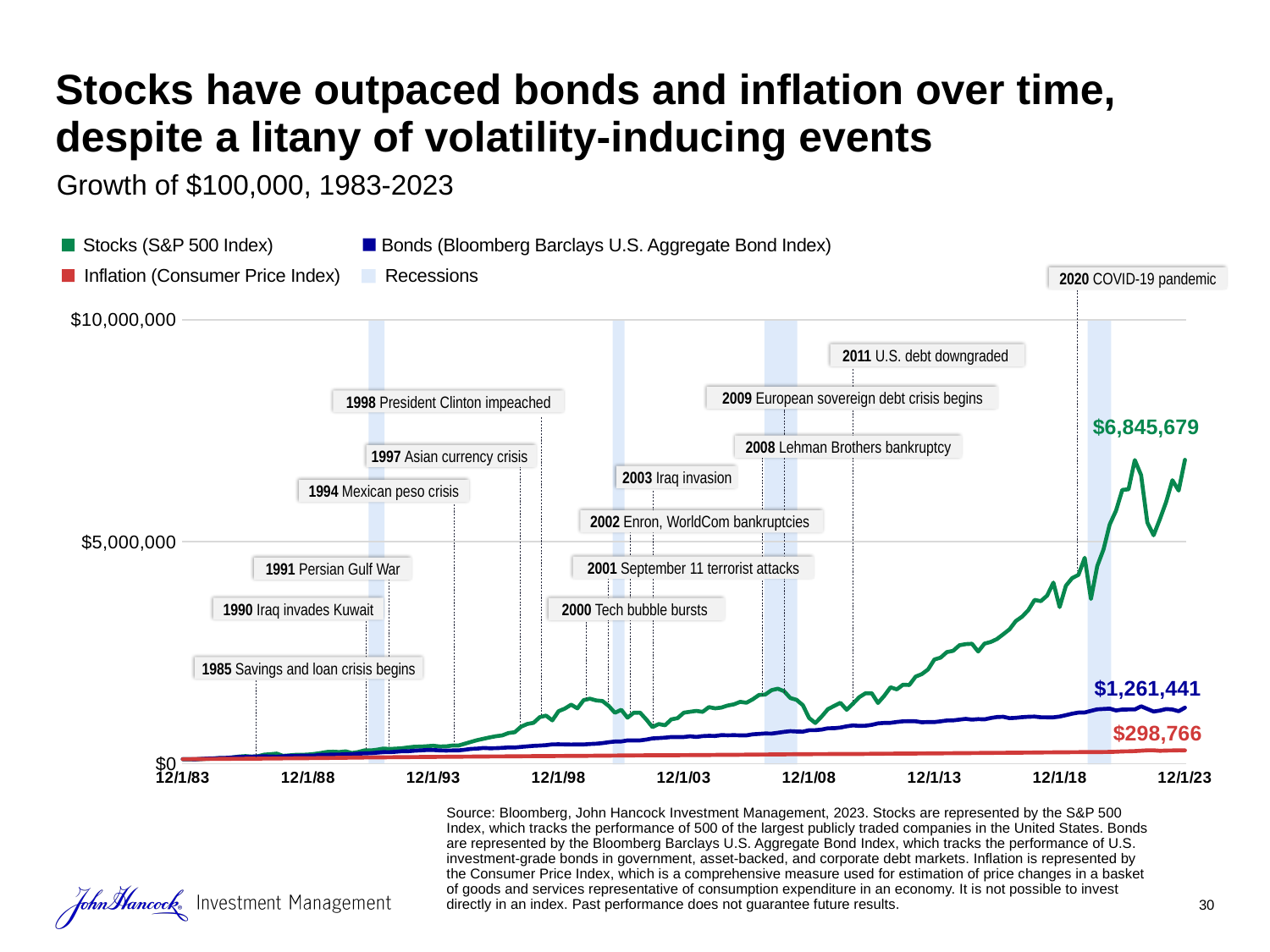
What is the ending value shown for Bonds (Bloomberg Barclays U.S. Aggregate Bond Index)? $1,261,441 How many entries does the legend list? 4 What is the ending value shown for Stocks (S&P 500 Index) on the chart? $6,845,679 What is the difference between the ending values of Bonds and Inflation? $962,675 What is the difference between the ending values of Stocks and Bonds? $5,584,238 What is the ending value shown for Inflation (Consumer Price Index)? $298,766 Is the ending value for Stocks greater or less than $5,000,000? greater Which series has the lowest ending value on the chart? Inflation (Consumer Price Index) Does the Stocks line generally rise or fall from 12/1/83 to 12/1/23? Rise What kind of chart is shown on the slide? Line chart Which series has the highest ending value on the chart? Stocks (S&P 500 Index) Which has a larger ending value, Bonds or Inflation? Bonds